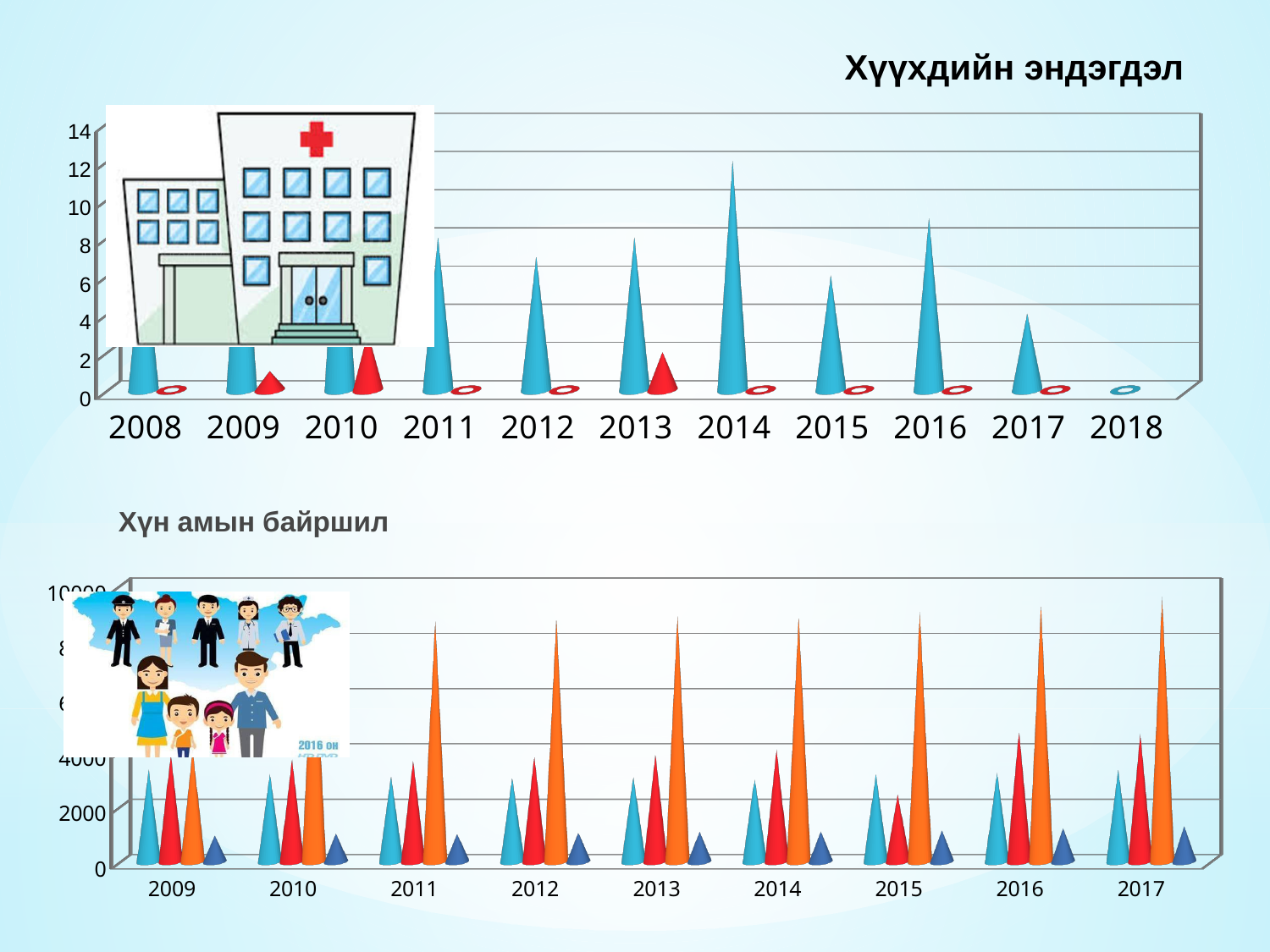
In the top chart 'Хүүхдийн эндэгдэл', how many years are shown on the x axis? 11 In the top chart 'Хүүхдийн эндэгдэл', is the blue value for 2014 greater or less than 10? greater In the bottom chart 'Хүн амын байршил', is the dark blue value for 2009 greater or less than 2000? less In the bottom chart 'Хүн амын байршил', is the orange value for 2017 greater or less than 8000? greater What kind of chart is the top chart titled 'Хүүхдийн эндэгдэл'? Bar chart In the top chart 'Хүүхдийн эндэгдэл', what is the blue value for 2018? 0 In the bottom chart 'Хүн амын байршил', which colour series has the highest value in 2013? Orange In the bottom chart 'Хүн амын байршил', how many years are shown on the x axis? 9 What is the title of the bottom chart? Хүн амын байршил In the top chart 'Хүүхдийн эндэгдэл', which is larger, the blue value for 2014 or for 2017? 2014